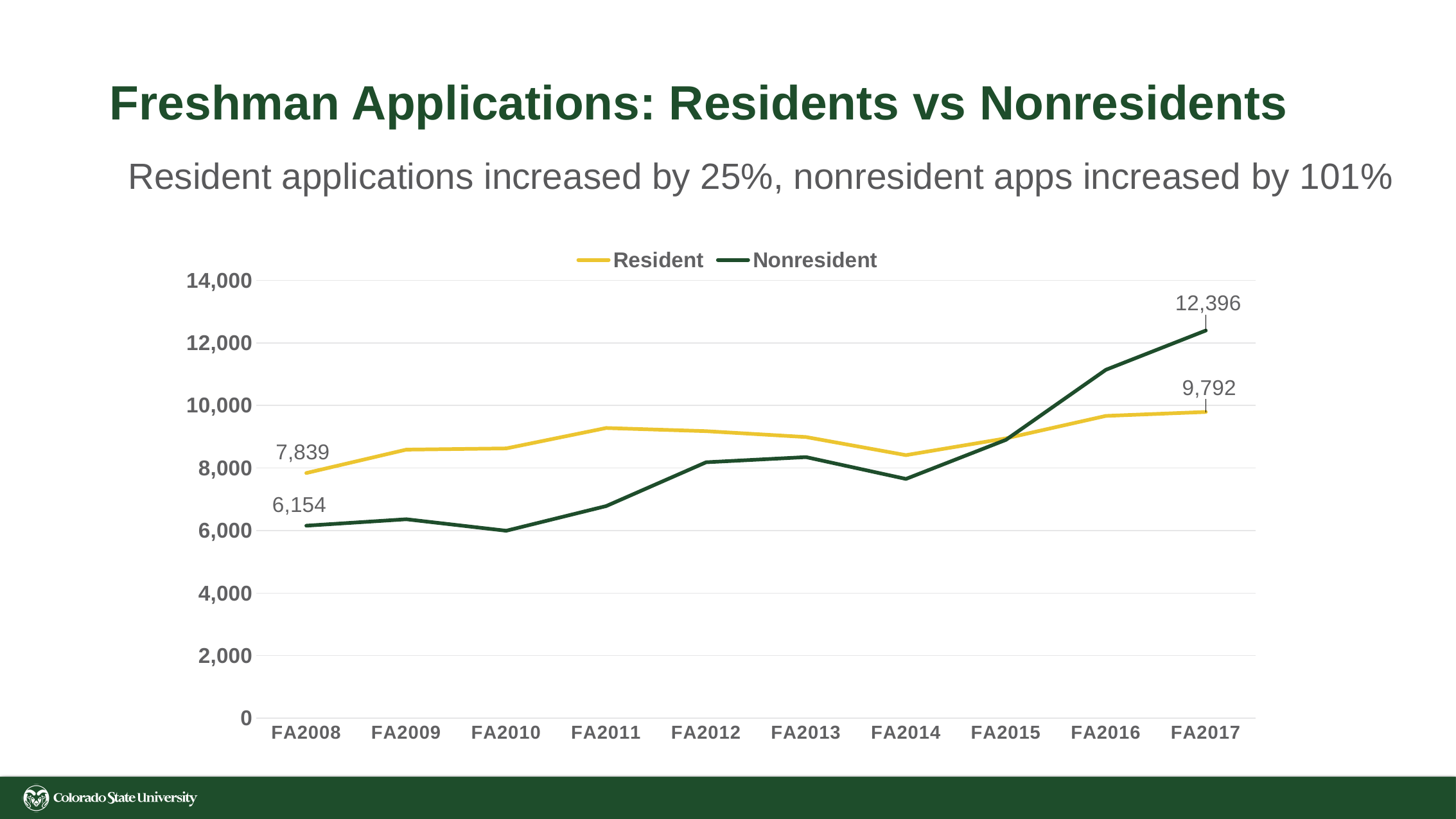
Is the value for Nonresident in FA2016 greater or less than 10,000? greater Is the value for Nonresident in FA2010 greater or less than 8,000? less What is the value for Nonresident in FA2017? 12,396 What is the value for Resident in FA2017? 9,792 In FA2008, which series has the larger value, Resident or Nonresident? Resident What is the value for Nonresident in FA2008? 6,154 By how much did the Nonresident value increase from FA2008 to FA2017? 6,242 How many terms are shown on the x axis? 10 What is the value for Resident in FA2008? 7,839 How many series does the legend list? 2 What is the difference between the Nonresident and Resident values in FA2017? 2,604 What kind of chart is shown on the slide? line chart